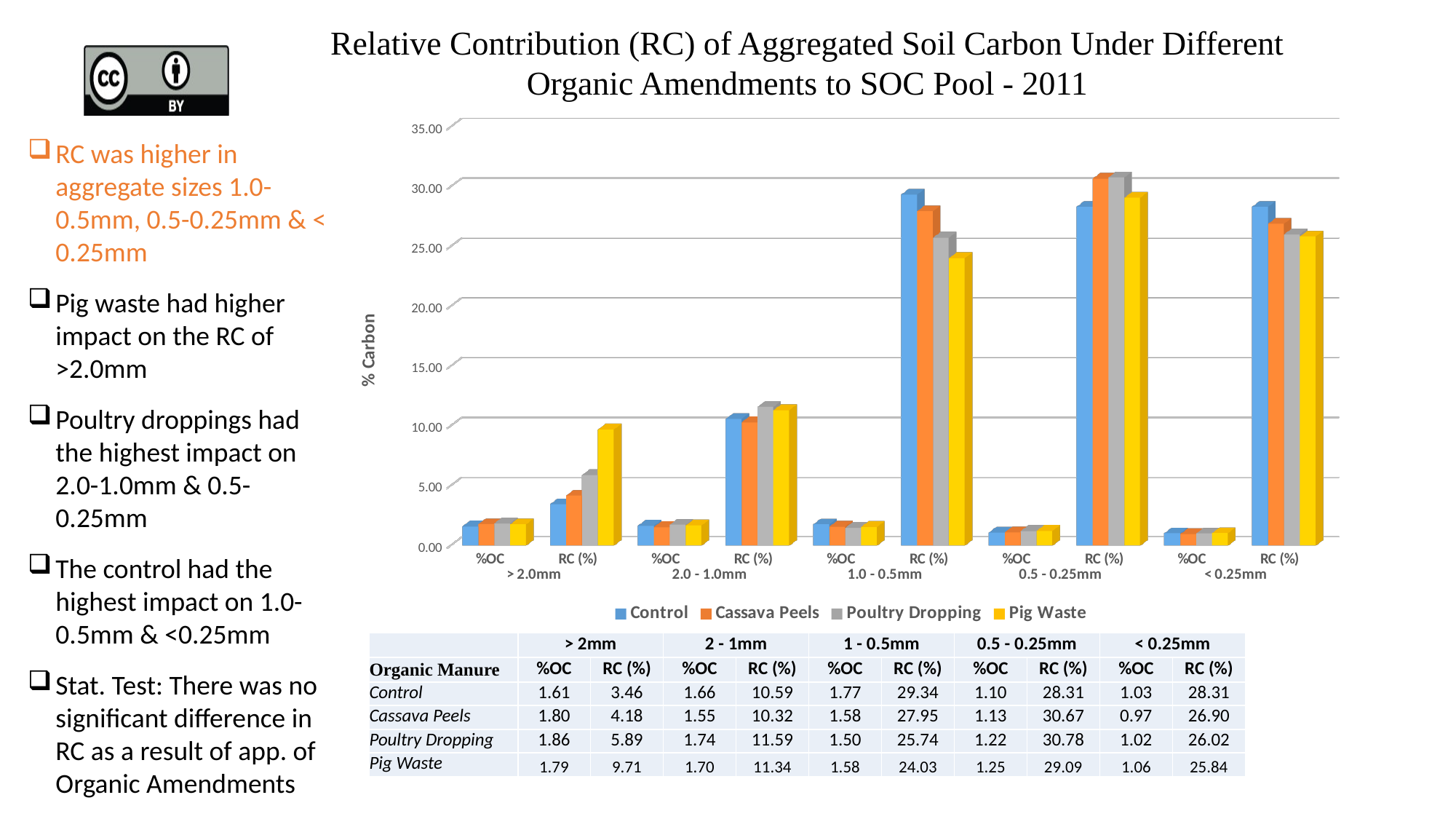
What kind of chart is shown on the slide? bar chart What is the difference between the RC (%) of Poultry Dropping and Control in the 2.0 - 1.0mm aggregate size? 1.00 What is the RC (%) value for Control in the 1 - 0.5mm aggregate size? 29.34 What is the RC (%) value for Poultry Dropping in the 0.5 - 0.25mm aggregate size? 30.78 Is the RC (%) value for Control in the 1 - 0.5mm aggregate size greater or less than 25.00? greater How many series does the chart legend list? 4 What is the difference between the RC (%) of Pig Waste and Control in the > 2mm aggregate size? 6.25 In the < 0.25mm aggregate size, which has the larger RC (%): Control or Cassava Peels? Control What is the label on the vertical axis of the chart? % Carbon What is the RC (%) value for Pig Waste in the > 2mm aggregate size? 9.71 Which organic amendment has the lowest RC (%) in the 1 - 0.5mm aggregate size? Pig Waste Which organic amendment has the highest RC (%) in the > 2mm aggregate size? Pig Waste